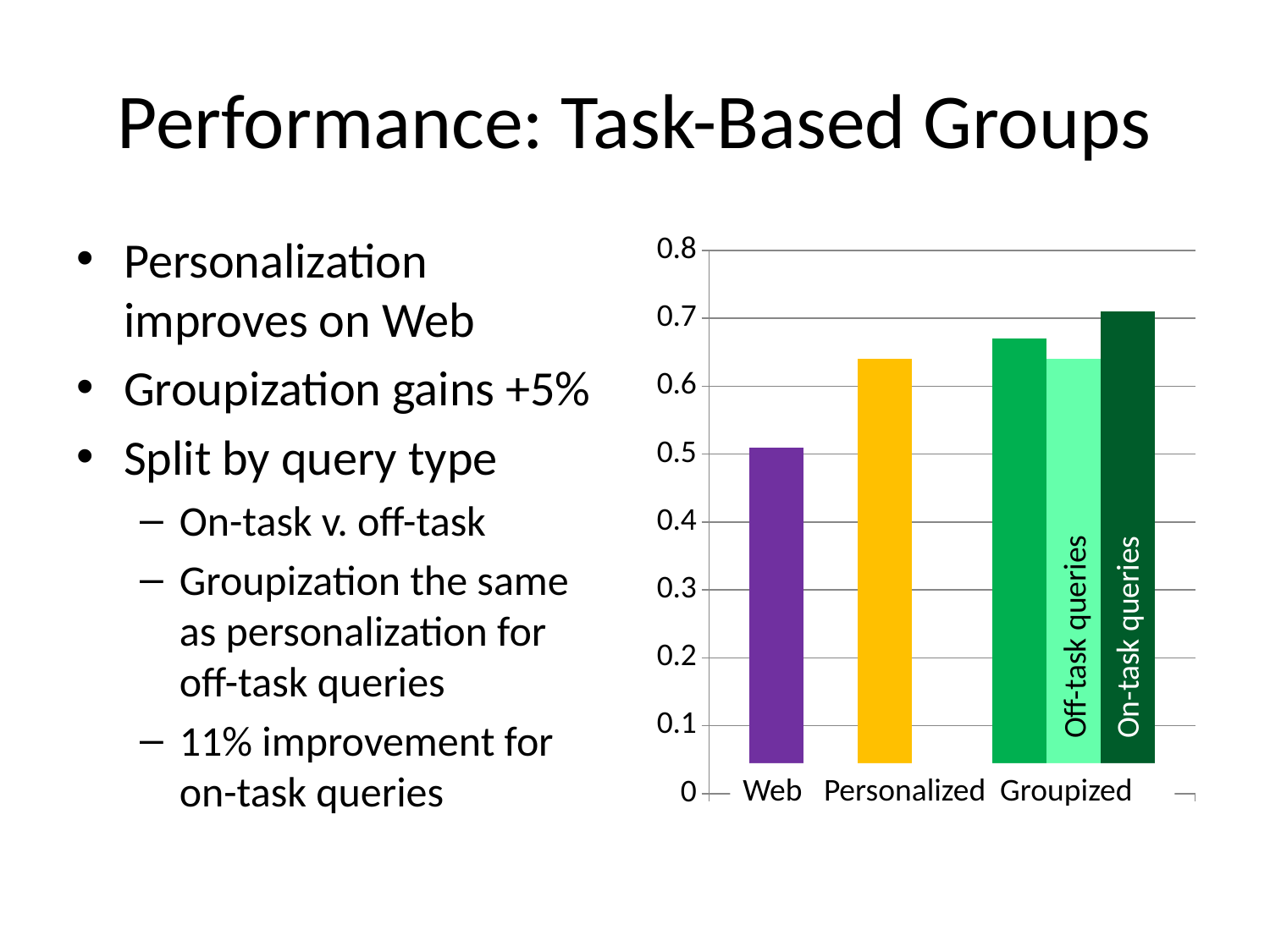
Which is larger, the value for Off-task queries or the value for On-task queries? On-task queries What kind of chart is shown on the slide? bar chart Which is larger, the value for Web or the value for Personalized? Personalized What is the highest value shown on the vertical axis? 0.8 Is the value for Groupized greater or less than 0.7? less Which bar in the chart is the lowest? Web Is the value for Web greater or less than 0.6? less Is the value for Personalized greater or less than 0.6? greater How many bars are plotted in the chart? 5 What colour is the Web bar? purple Which bar in the chart is the highest? On-task queries